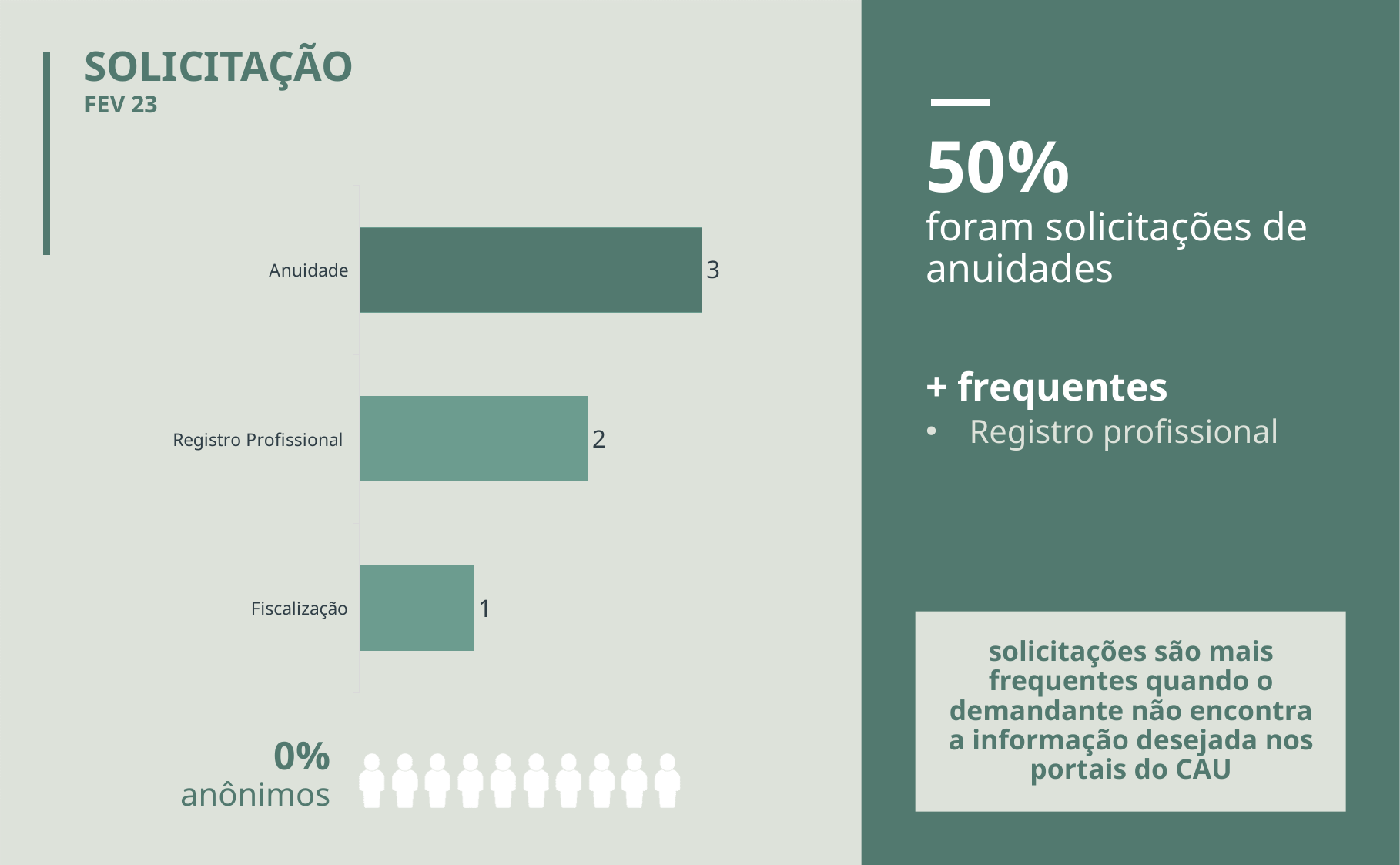
What is the title of the chart on the slide? SOLICITAÇÃO What is the value for Registro Profissional? 2 What kind of chart is shown on the slide? Bar chart How many categories are shown in the chart? 3 Which category has the lowest value? Fiscalização What is the value for Fiscalização? 1 Which is larger, the value for Registro Profissional or the value for Fiscalização? Registro Profissional What is the total of all three bar values in the chart? 6 What is the difference between the values for Anuidade and Fiscalização? 2 What is the value for Anuidade? 3 Which category has the highest value? Anuidade What is the difference between the values for Anuidade and Registro Profissional? 1